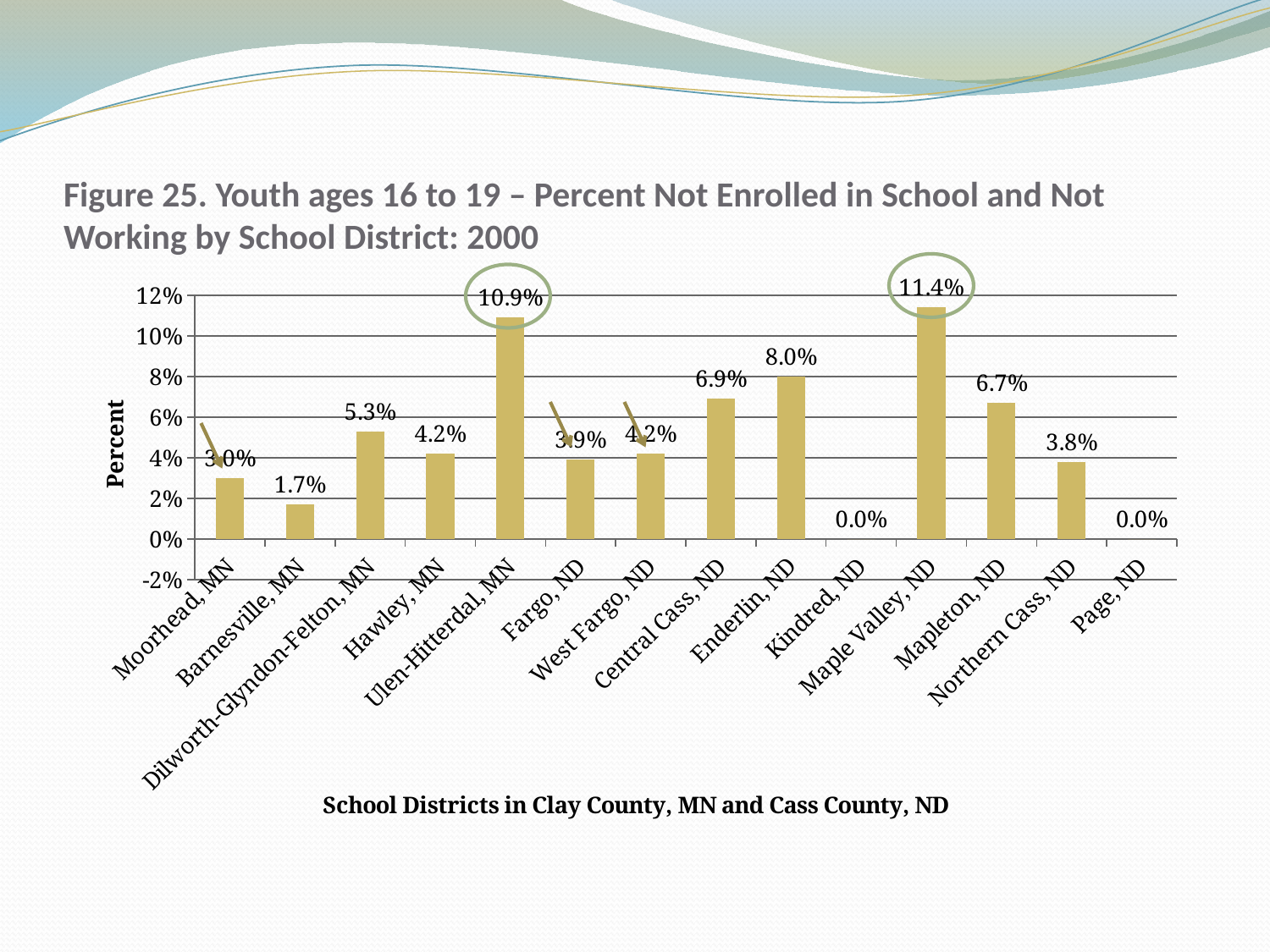
What is the difference between the values for Enderlin, ND and Moorhead, MN? 5.0% Is the value for Dilworth-Glyndon-Felton, MN greater or less than 4%? greater What is the difference between the values for Maple Valley, ND and Ulen-Hitterdal, MN? 0.5% What is the value for Northern Cass, ND? 3.8% What is the title of the vertical axis? Percent What kind of chart is shown on the slide? bar chart What is the value for Enderlin, ND? 8.0% What is the value for Ulen-Hitterdal, MN? 10.9% How many school districts are plotted on the chart? 14 What is the value for Barnesville, MN? 1.7% Which school district has the highest percent of youth not enrolled in school and not working? Maple Valley, ND Which is larger, the value for Central Cass, ND or the value for Mapleton, ND? Central Cass, ND